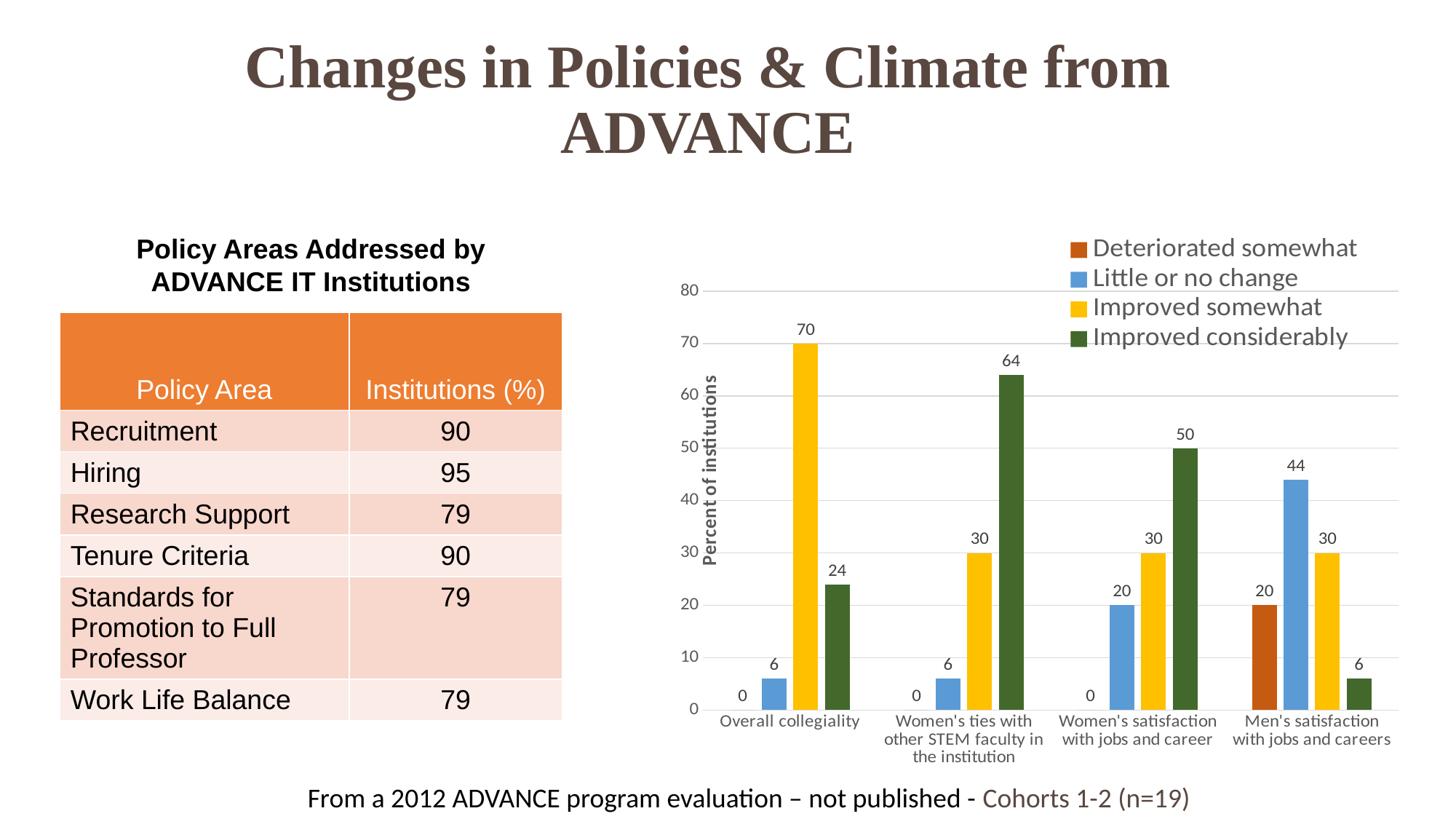
How many series does the legend of the bar chart list? 4 In the bar chart, what is the value for 'Improved somewhat' for Overall collegiality? 70 In the bar chart, what is the value for 'Deteriorated somewhat' for Women's satisfaction with jobs and career? 0 In the bar chart, what is the value for 'Improved considerably' for Women's ties with other STEM faculty in the institution? 64 How many categories are shown on the x axis of the bar chart? 4 What is the y-axis label of the bar chart? Percent of institutions In the bar chart, which category has the lowest 'Improved considerably' value? Men's satisfaction with jobs and careers In the bar chart, what is the difference between 'Improved somewhat' and 'Improved considerably' for Overall collegiality? 46 In the bar chart, which category has the highest 'Improved considerably' value? Women's ties with other STEM faculty in the institution In the bar chart, what is the value for 'Little or no change' for Men's satisfaction with jobs and careers? 44 In the bar chart, which is larger for Women's satisfaction with jobs and career: 'Improved considerably' or 'Improved somewhat'? Improved considerably What kind of chart is shown on the right of the slide? Bar chart